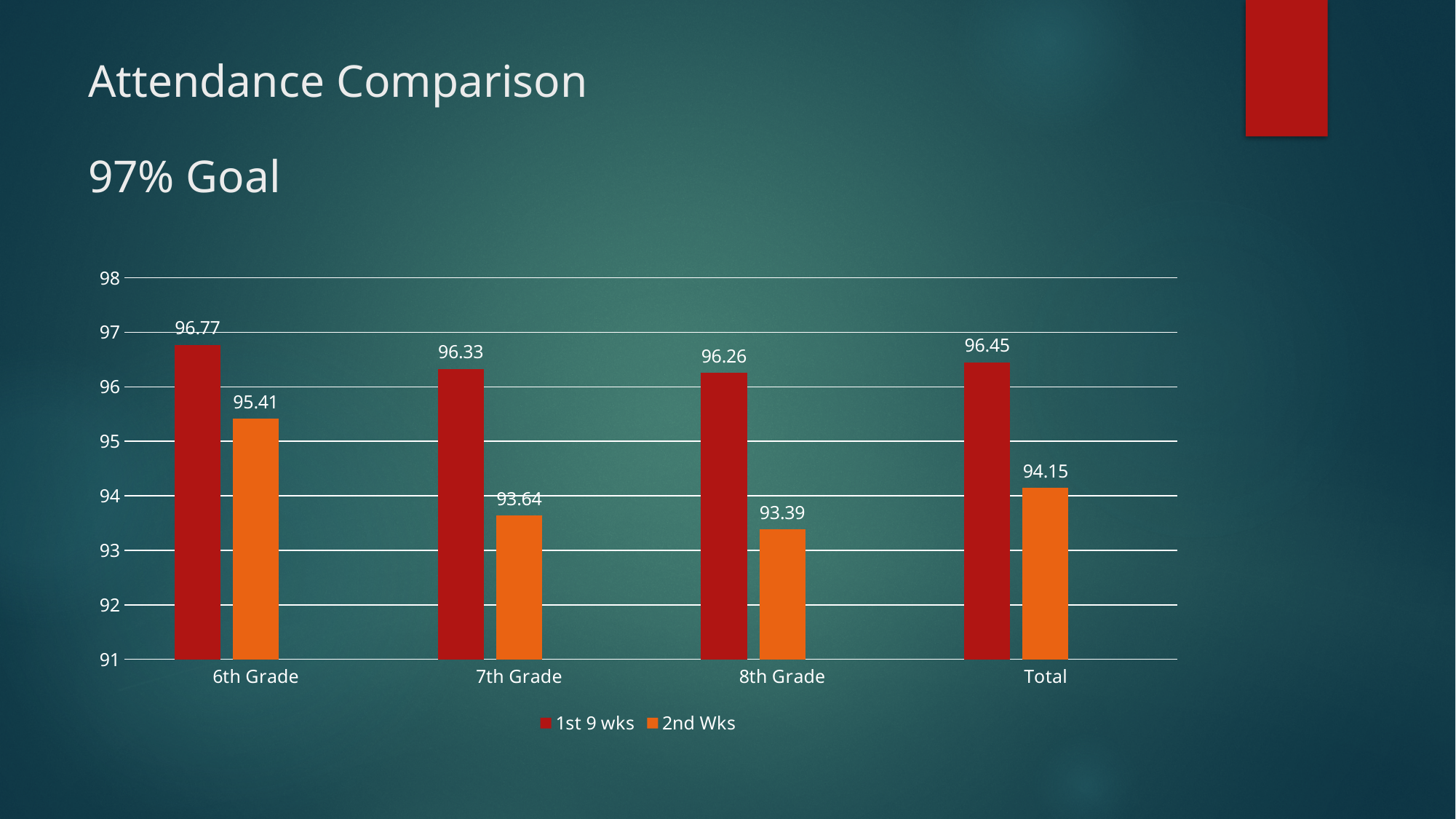
What is the 2nd Wks value for Total? 94.15 What goal percentage is stated in the slide title? 97% Is the 2nd Wks value for 6th Grade greater or less than 95? greater How many categories are shown on the x axis? 4 Which is larger for 6th Grade: the 1st 9 wks value or the 2nd Wks value? 1st 9 wks What kind of chart is shown on the slide? bar chart Which category has the highest 1st 9 wks value? 6th Grade Which category has the lowest 2nd Wks value? 8th Grade What is the 2nd Wks attendance value for 8th Grade? 93.39 How many series does the legend list? 2 What is the 1st 9 wks attendance value for 6th Grade? 96.77 What is the difference between the 1st 9 wks and 2nd Wks values for 7th Grade? 2.69